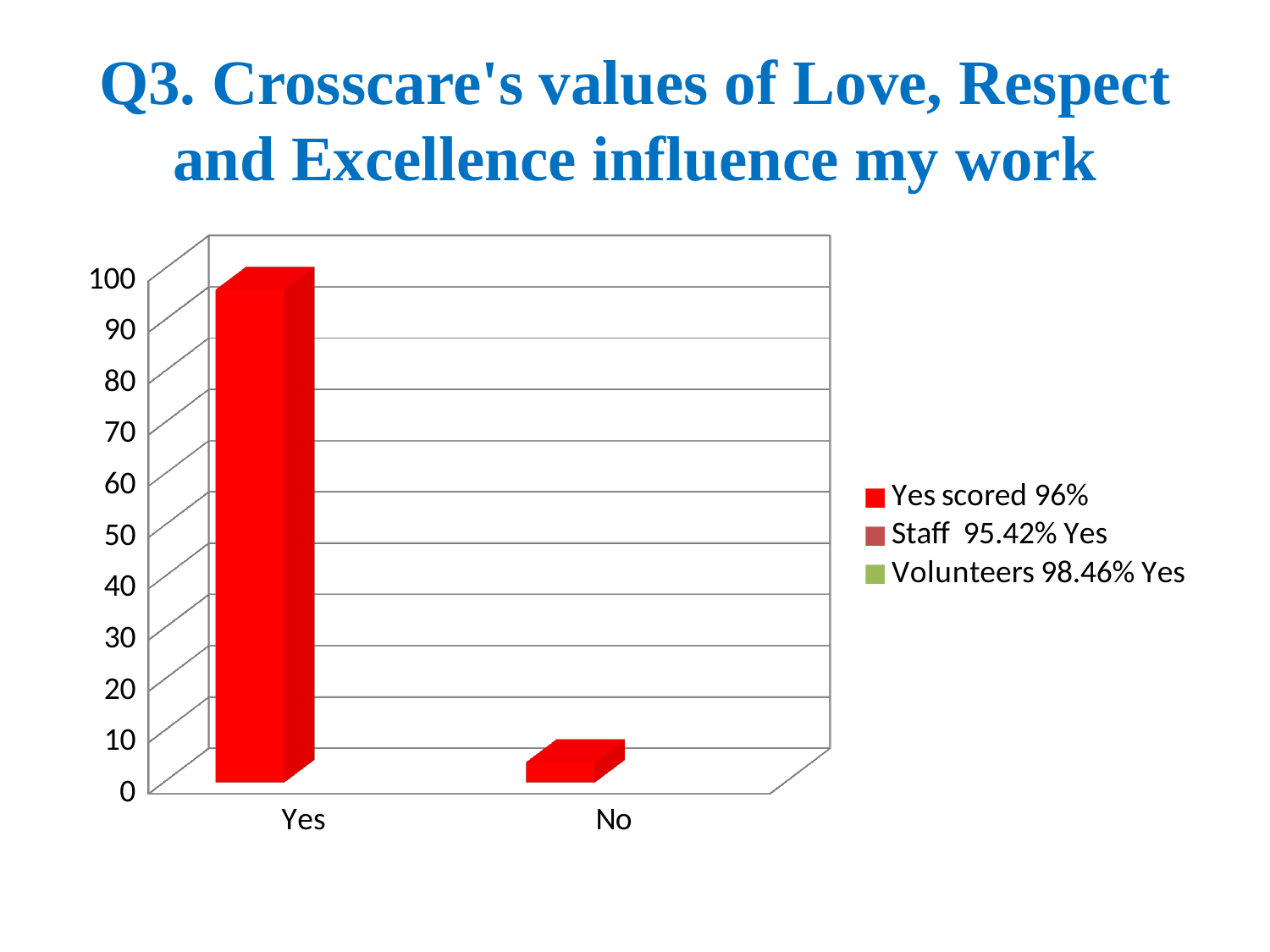
According to the legend, what percentage of Volunteers answered Yes? 98.46% Which category has the highest bar? Yes How many categories are shown on the x axis of the chart? 2 Is the value for No greater or less than 20? less What is the title of the slide containing the chart? Q3. Crosscare's values of Love, Respect and Excellence influence my work Which category has the lowest bar? No Which bar is taller, Yes or No? Yes Is the value for Yes greater or less than 50? greater Is the value for Yes greater or less than 90? greater How many entries does the chart's legend list? 3 What kind of chart is shown on the slide? bar chart